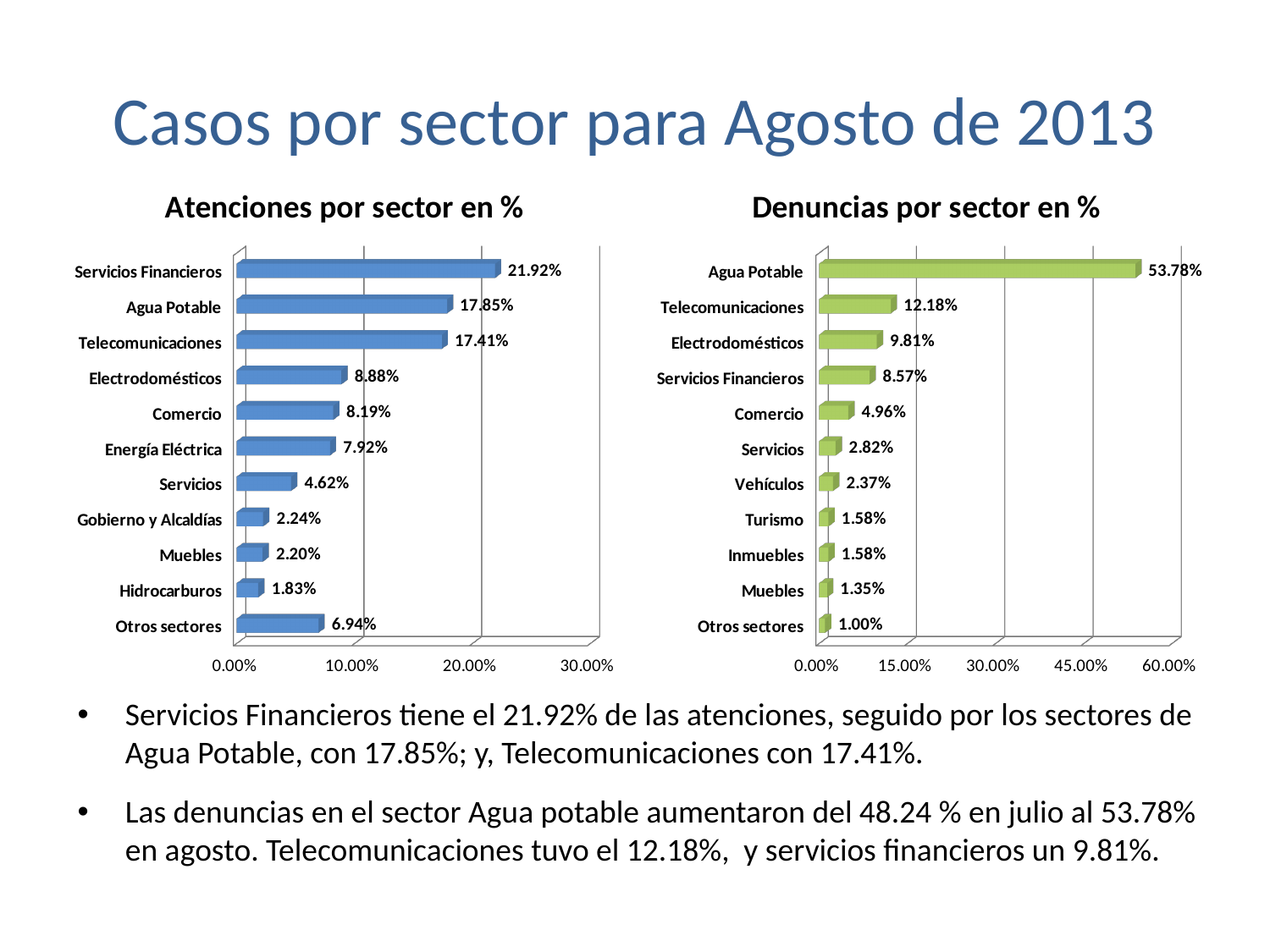
In the 'Atenciones por sector en %' chart, what is the difference between Agua Potable and Telecomunicaciones? 0.44% How many sectors are shown in the 'Atenciones por sector en %' chart? 11 What kind of chart is 'Denuncias por sector en %'? Bar chart In the 'Denuncias por sector en %' chart, which sector has the highest value? Agua Potable In the 'Atenciones por sector en %' chart, which sector has the lowest value? Hidrocarburos How many sectors are shown in the 'Denuncias por sector en %' chart? 11 In the 'Denuncias por sector en %' chart, which is larger: Electrodomésticos or Servicios Financieros? Electrodomésticos In the 'Atenciones por sector en %' chart, which is larger: Comercio or Energía Eléctrica? Comercio In the 'Atenciones por sector en %' chart, what is the value for Servicios Financieros? 21.92% What colour are the bars in the 'Atenciones por sector en %' chart? Blue In the 'Denuncias por sector en %' chart, what is the value for Telecomunicaciones? 12.18% In the 'Denuncias por sector en %' chart, what is the difference between Agua Potable and Telecomunicaciones? 41.60%